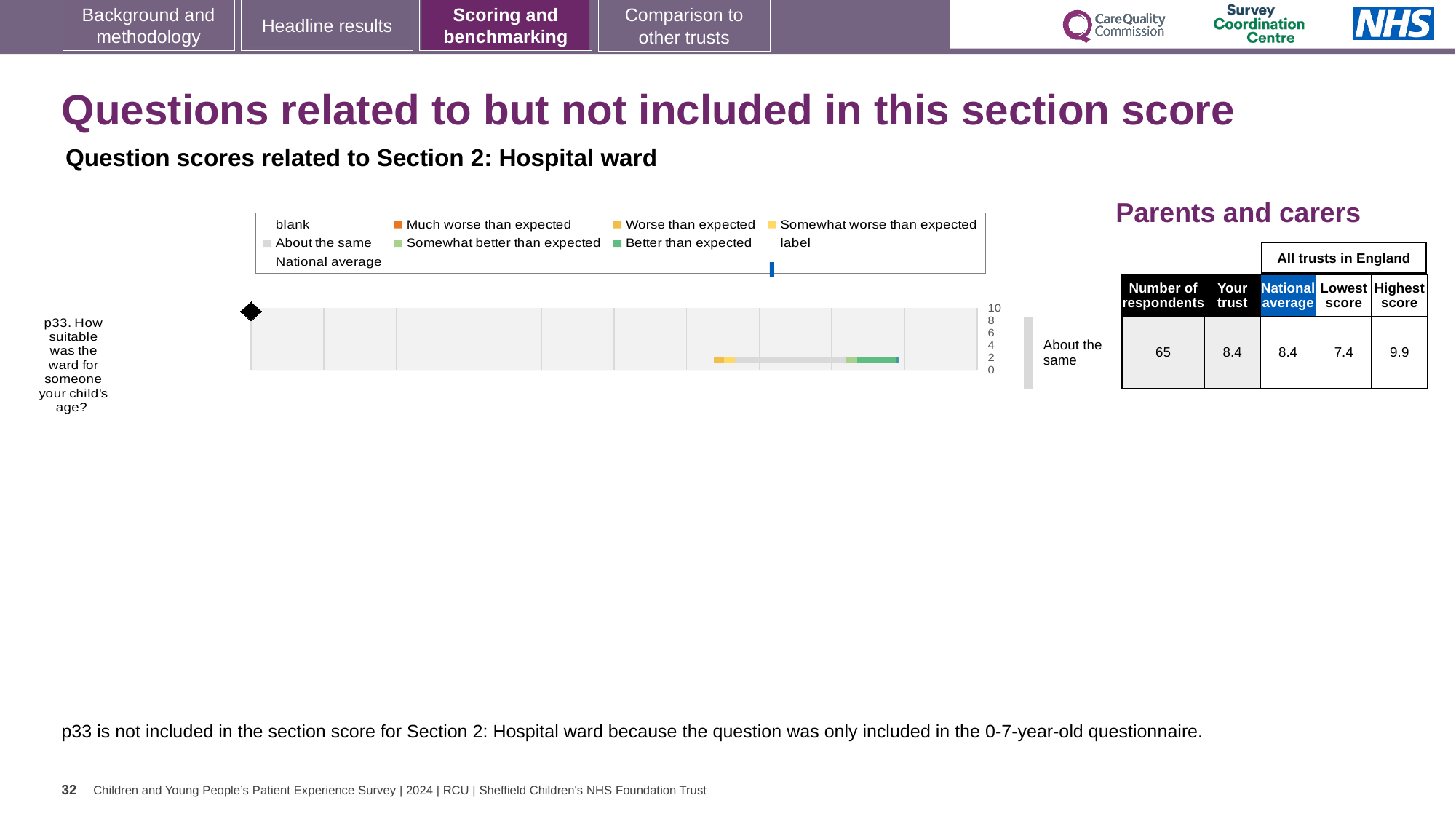
How many respondents answered p33? 65 Which benchmark category is shown next to the bar for p33? About the same Is the 'Your trust' score for p33 higher or lower than the national average? equal What is the highest score among all trusts in England for p33? 9.9 What is the difference between the highest score and the lowest score for p33? 2.5 How many entries does the chart legend list? 9 What is the 'Your trust' score for p33 in the table beside the chart? 8.4 What is the lowest score among all trusts in England for p33? 7.4 What is the highest value shown on the chart's score axis? 10 What is the national average score for p33? 8.4 What kind of chart is used to show the p33 question score? bar chart How many questions (categories) are plotted in the chart? 1